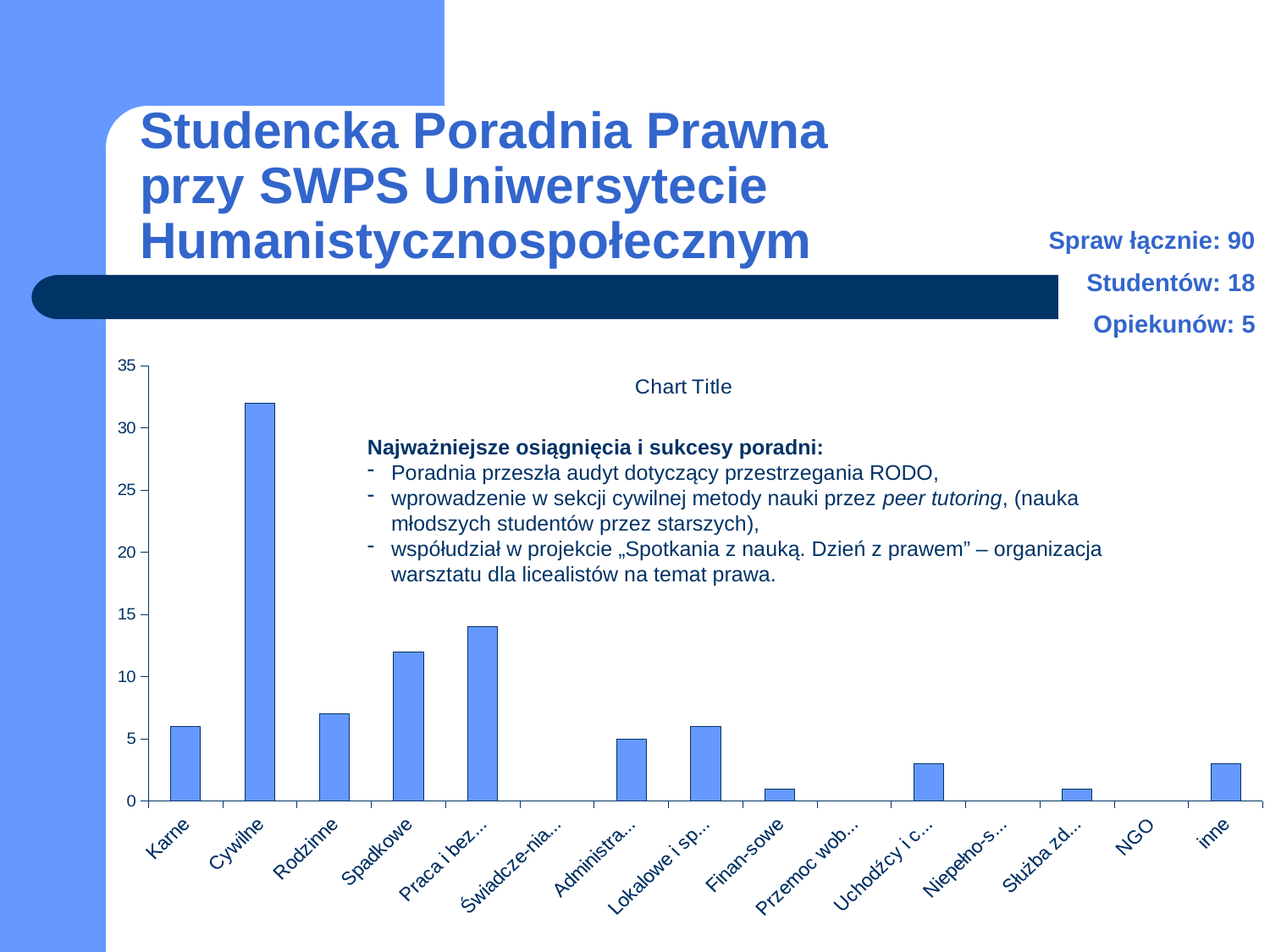
What is the title shown on the chart? Chart Title Which is larger, the value for Spadkowe or the value for Karne? Spadkowe Is the value for Karne greater or less than 10? less Is the value for Rodzinne greater or less than 10? less How many categories are shown on the x axis of the chart? 15 Which category has the highest bar in the chart? Cywilne Is the value for Cywilne greater or less than 30? greater What kind of chart is shown on the slide? bar chart Which is larger, the value for Cywilne or the value for Spadkowe? Cywilne